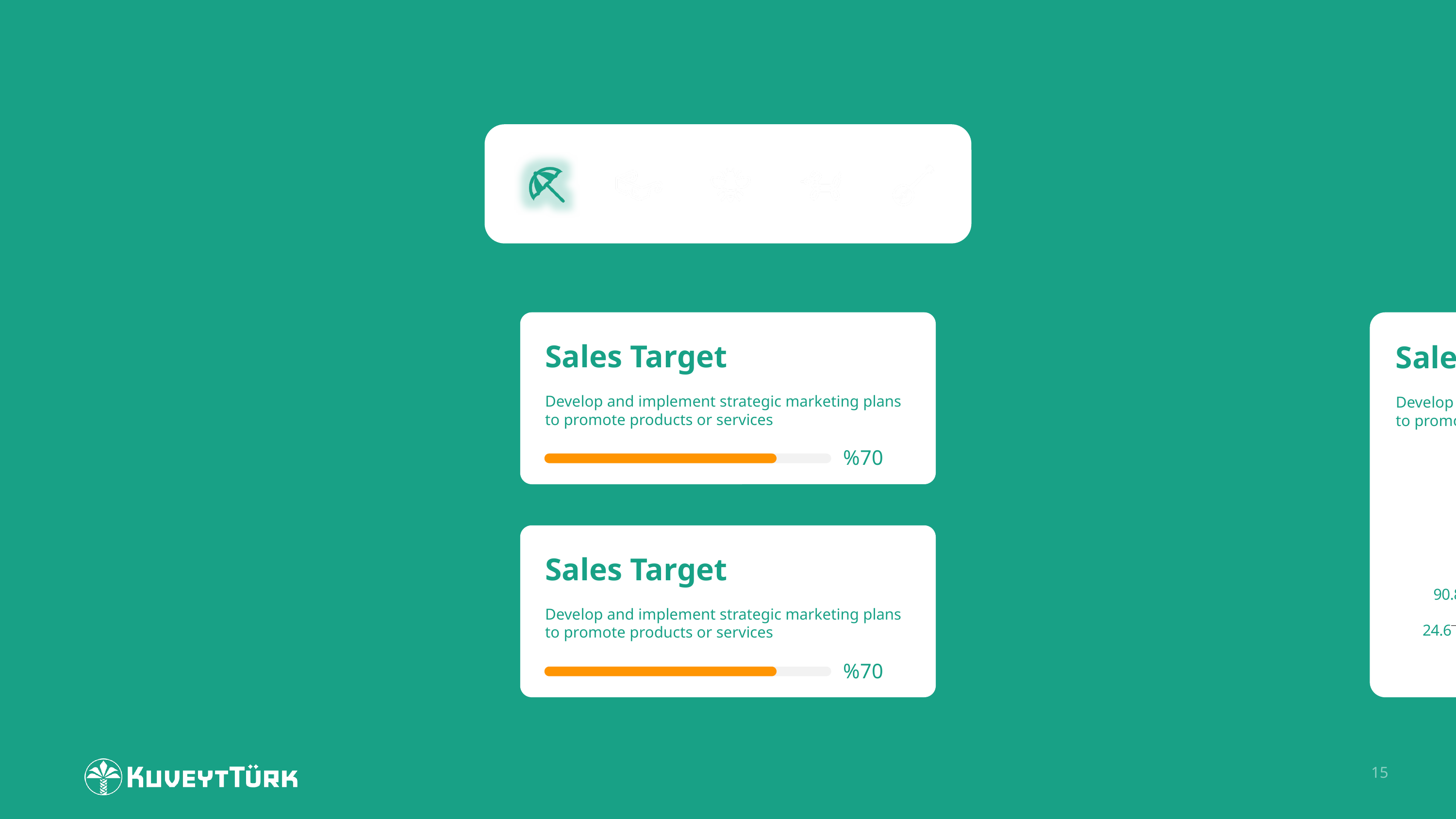
Is the value shown on the upper Sales Target progress bar greater or less than 50%? greater What is the title of the card containing the upper progress bar? Sales Target Is the value shown on the lower Sales Target progress bar greater or less than 100%? less On the lower Sales Target card, what percentage does the progress bar show? %70 What colour is the filled portion of the progress bars on the Sales Target cards? Orange On the upper Sales Target card, what percentage does the progress bar show? %70 How many Sales Target progress bars are fully visible on the slide? 2